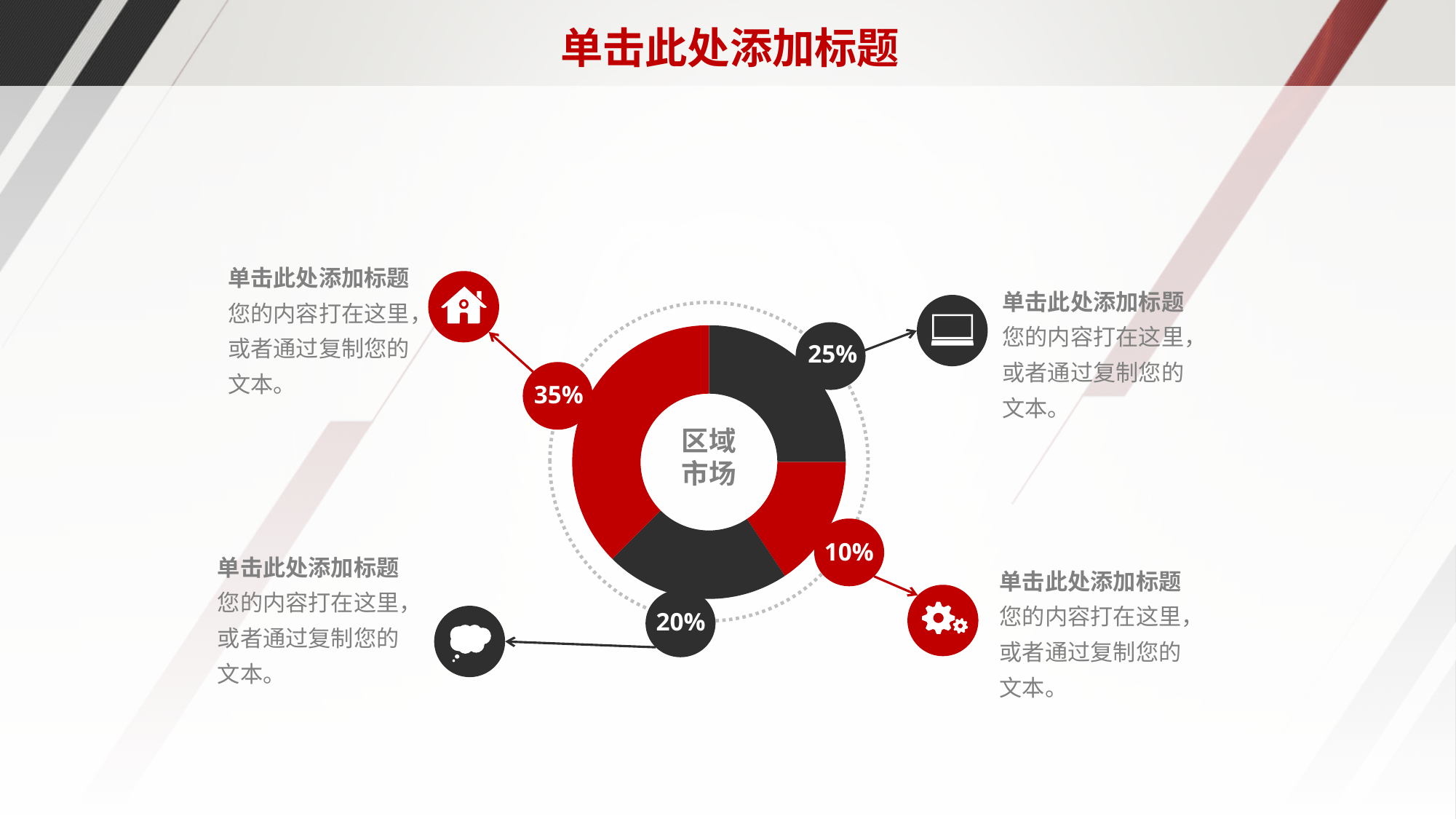
Which is larger: the slice labelled 25% or the slice labelled 20%? 25% What do the four percentage labels on the donut chart add up to? 90% What percentage is labelled on the slice at the bottom of the donut chart? 20% What two colours are used for the slices of the donut chart? Red and dark grey/black How many slices does the donut chart have? 4 What text is written in the centre of the donut chart? 区域市场 What percentage is labelled on the dark slice at the top right of the donut chart? 25% What is the difference between the largest slice (35%) and the smallest slice (10%)? 25% What kind of chart is shown on the slide? Donut (pie) chart What is the largest percentage shown on the donut chart? 35% What is the smallest percentage shown on the donut chart? 10% What percentage is labelled on the large red slice on the left of the donut chart? 35%